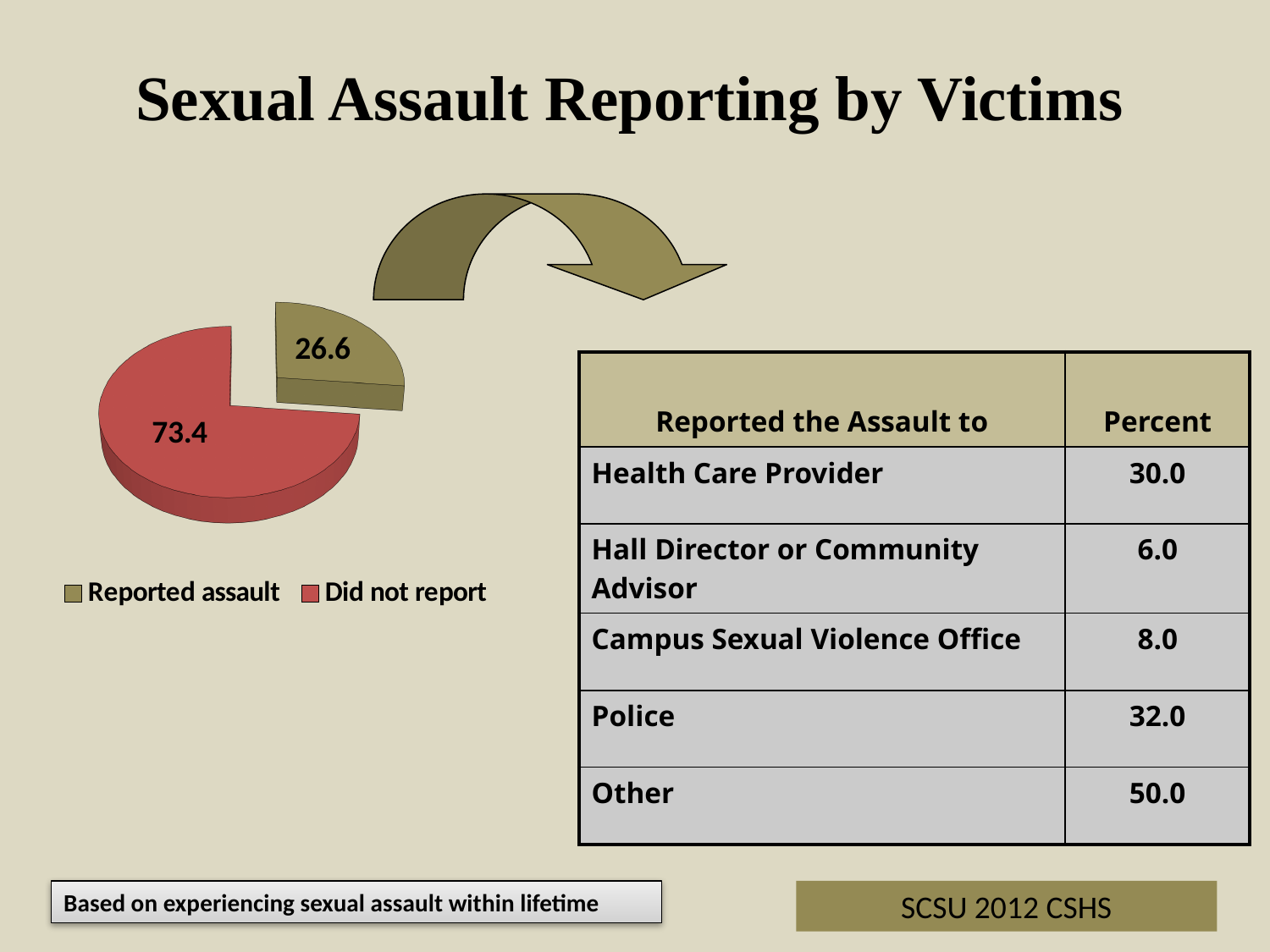
Which slice of the pie chart is the largest? Did not report What share of the pie does the "Reported assault" slice represent? 26.6 What type of chart is shown on the slide? Pie chart Which slice of the pie chart is the smallest? Reported assault How many slices does the pie chart have? 2 Which is larger in the pie chart, "Reported assault" or "Did not report"? Did not report What value is shown for the "Did not report" slice of the pie chart? 73.4 What value is shown for the "Reported assault" slice of the pie chart? 26.6 What colour is the "Did not report" slice in the pie chart? Red What is the difference between the "Did not report" and "Reported assault" values in the pie chart? 46.8 How many entries does the pie chart's legend list? 2 What is the title of the slide containing the pie chart? Sexual Assault Reporting by Victims